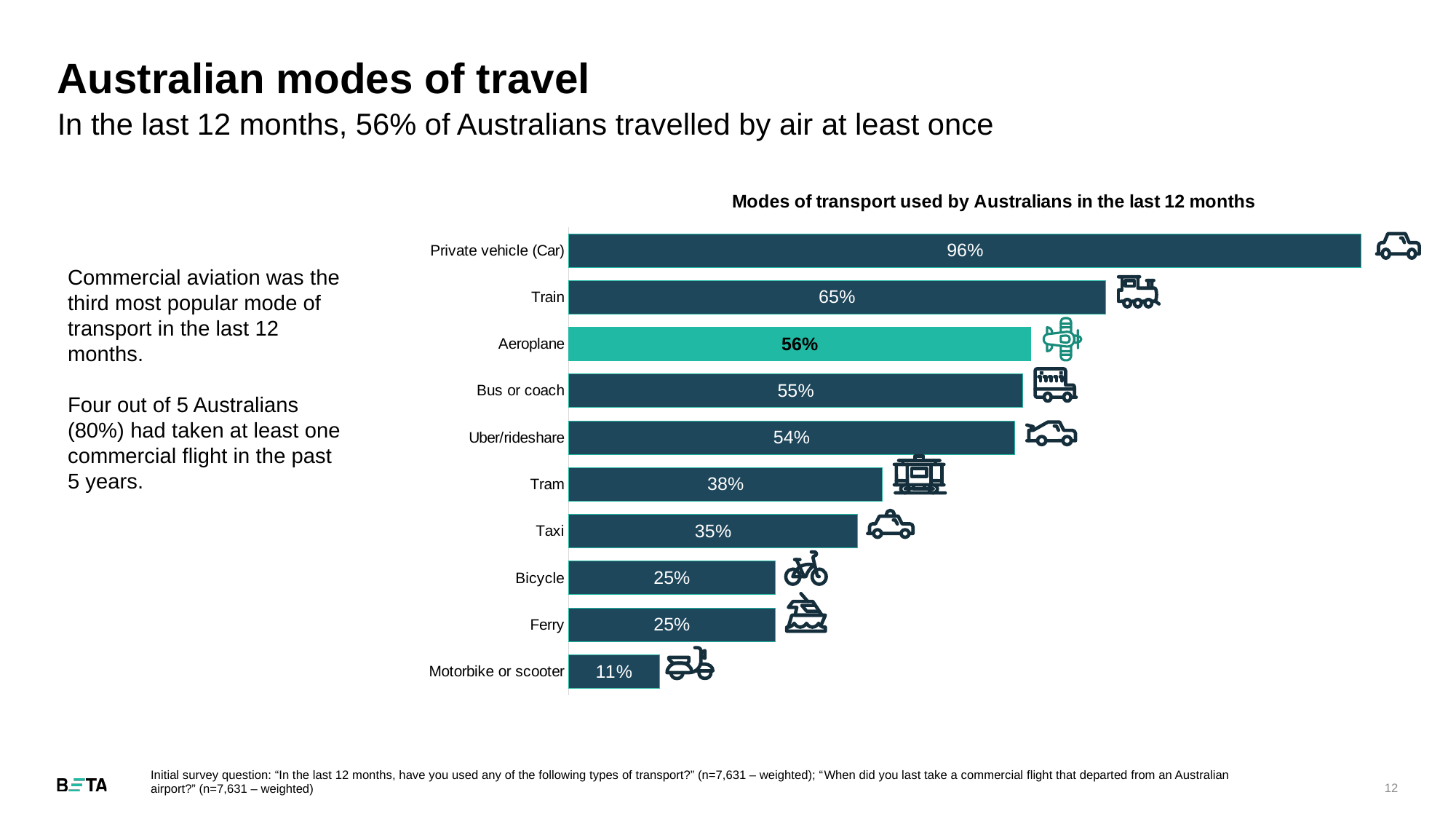
Which mode of transport has the highest value? Private vehicle (Car) What is the difference between the values for Train and Aeroplane? 9% What percentage of Australians used a private vehicle (car) in the last 12 months? 96% What kind of chart is shown on the slide? Bar chart What is the title of the chart? Modes of transport used by Australians in the last 12 months What is the value shown for Aeroplane? 56% What is the value shown for Tram? 38% What is the difference between the values for Private vehicle (Car) and Motorbike or scooter? 85% How many modes of transport are shown in the chart? 10 Which bar is highlighted in a different colour (green) from the others? Aeroplane Which is larger, the value for Tram or the value for Taxi? Tram Which mode of transport has the lowest value? Motorbike or scooter